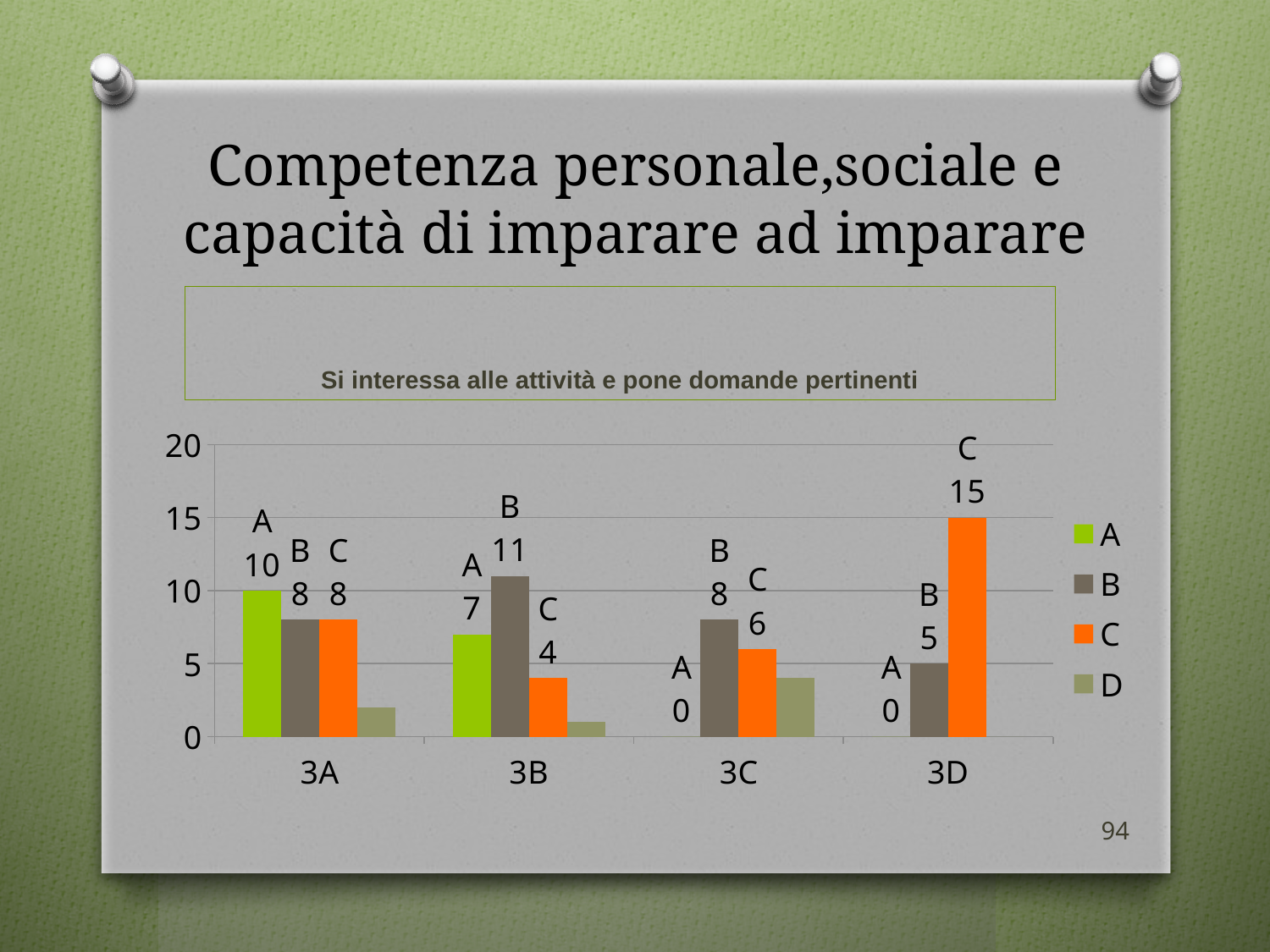
Is the value of series D for category 3A greater or less than 5? less For category 3B, which is larger: series A or series B? B What is the value of series A for category 3A? 10 What is the value of series C for category 3D? 15 How many series does the legend list? 4 What is the value of series A for category 3C? 0 How many categories are shown on the x axis? 4 Which category has the lowest value for series C? 3B What is the value of series B for category 3B? 11 What is the difference between series C and series B for category 3D? 10 What type of chart is shown on the slide? bar chart Which category has the highest value for series C? 3D